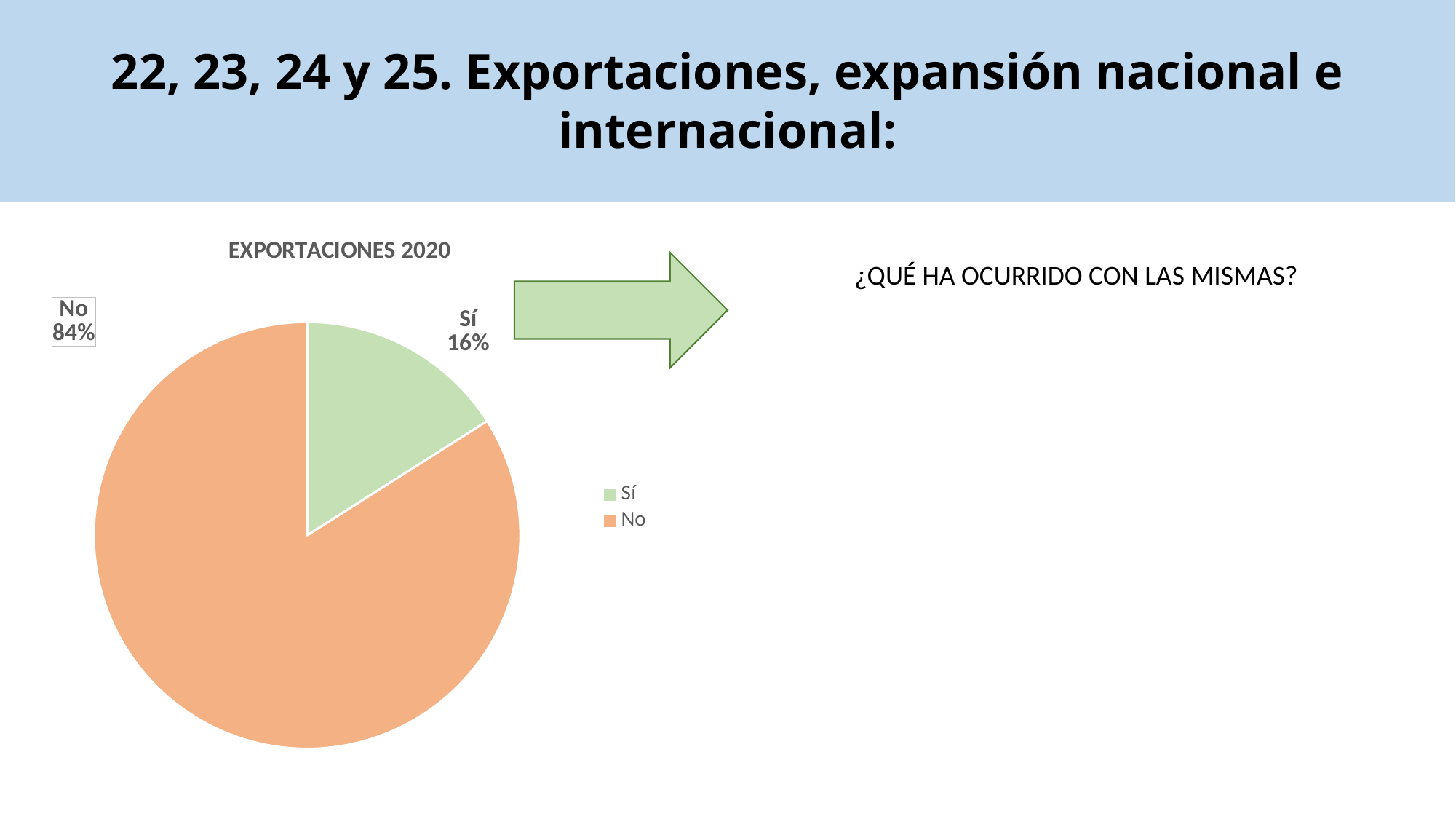
What is the title of the chart? EXPORTACIONES 2020 Which category has the largest slice of the pie? No Which is larger, the 'Sí' slice or the 'No' slice? No What colour is the 'No' slice in the pie chart? orange What share of the pie does the 'Sí' slice represent? 16% What kind of chart is shown on the slide? pie chart How many entries does the legend list? 2 What is the difference in percentage points between the 'No' and 'Sí' slices? 68 How many slices does the pie chart have? 2 Which category has the smallest slice of the pie? Sí What share of the pie does the 'No' slice represent? 84%